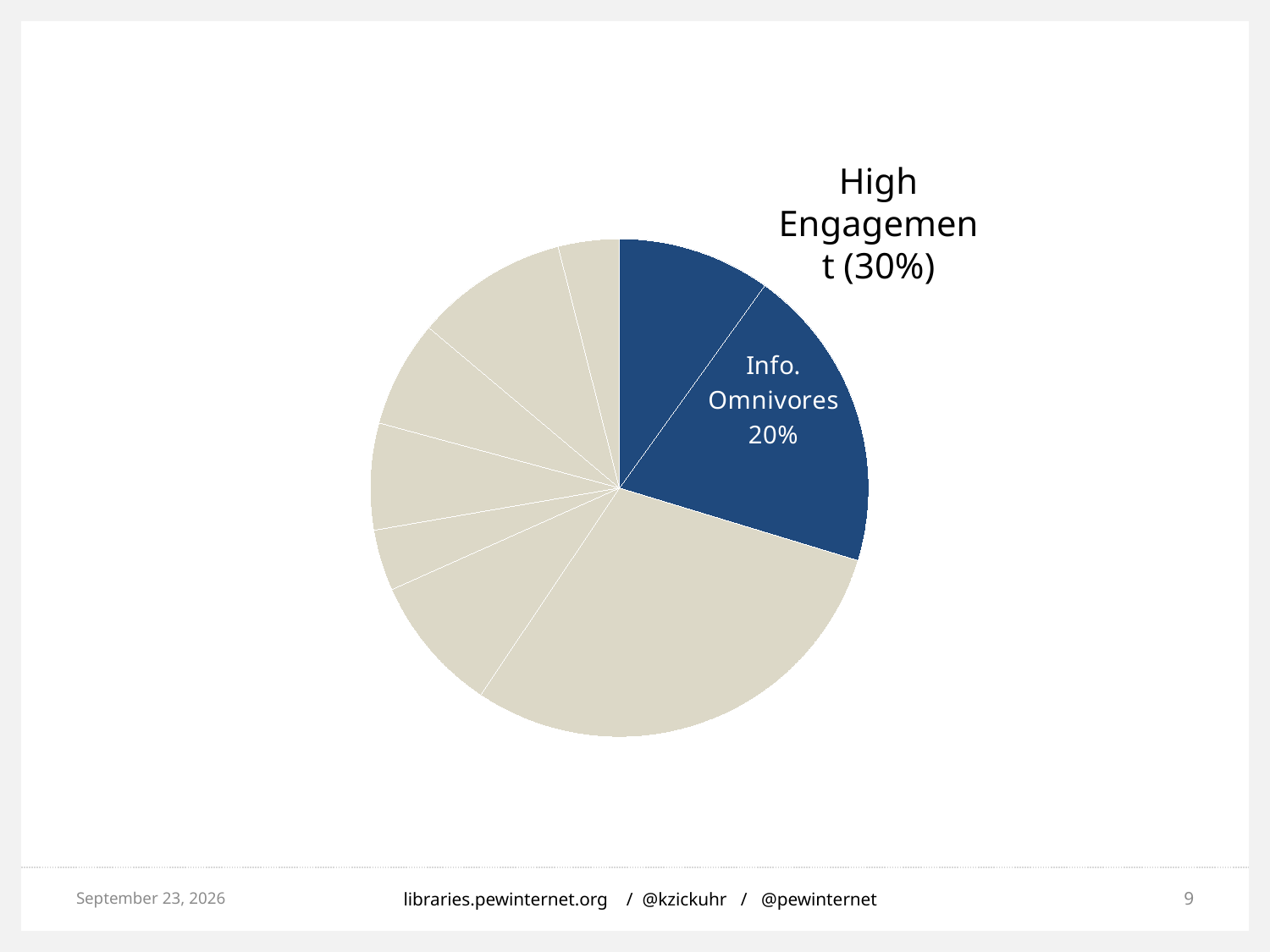
Which is larger: the Info. Omnivores slice or the other blue slice next to it? Info. Omnivores Is the share of the largest beige slice greater or less than 50%? less How many slices of the pie are coloured blue? 2 What kind of chart is shown on the slide? pie chart What percentage is shown for the Info. Omnivores slice? 20% What percentage is given for High Engagement? 30% Is the share of the largest beige slice greater or less than 10%? greater What share of the pie does the Info. Omnivores slice represent? 20% By how many percentage points does High Engagement (30%) exceed Info. Omnivores (20%)? 10% Which slice of the pie has a percentage label printed inside it? Info. Omnivores What colour is the Info. Omnivores slice? blue